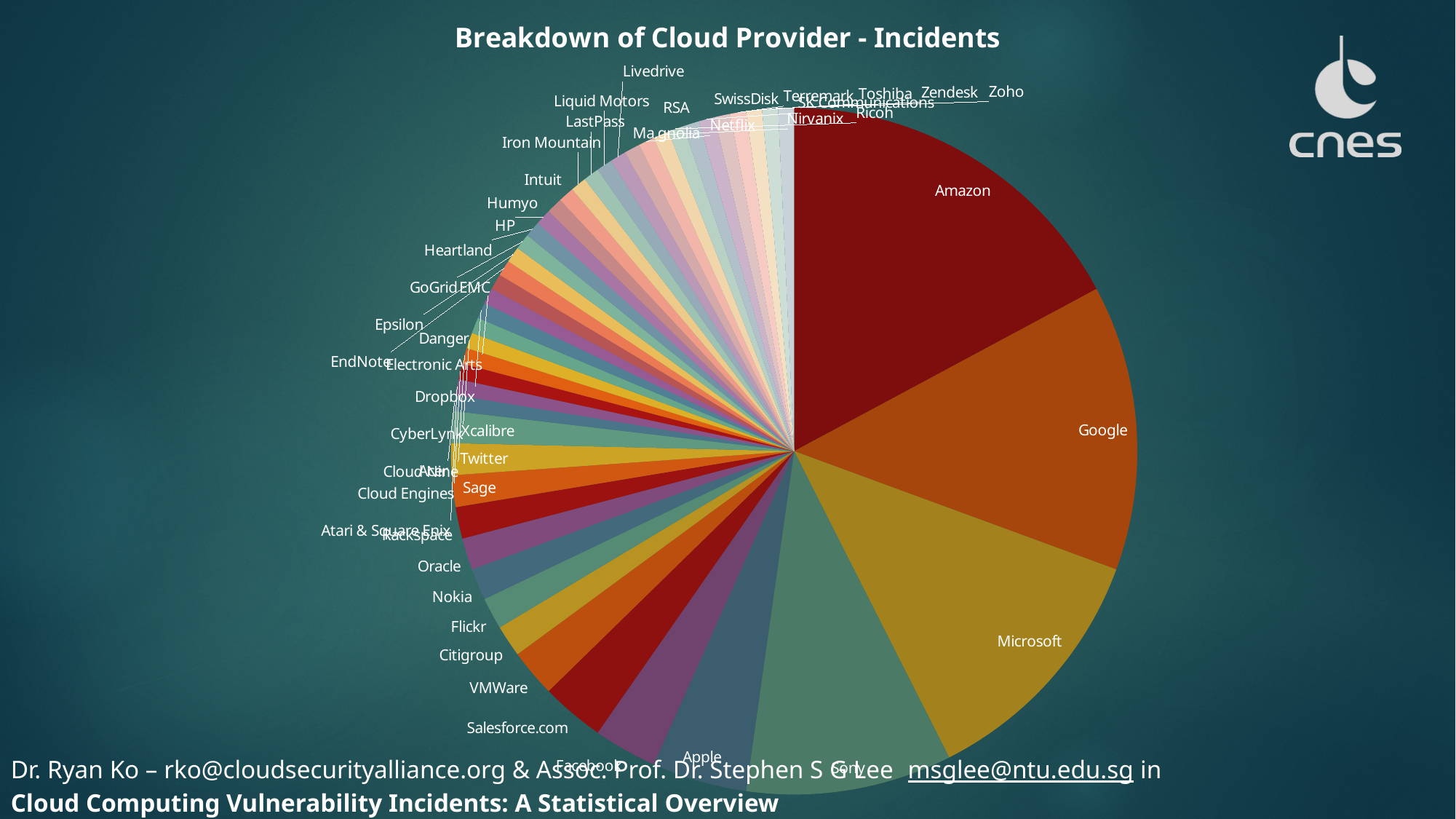
Which slice is larger, Sony or Facebook? Sony What kind of chart is shown on the slide? pie chart Which cloud provider has the largest slice of the pie? Amazon Which slice is larger, Amazon or Microsoft? Amazon Which slice is larger, Microsoft or Salesforce.com? Microsoft What is the title of the chart? Breakdown of Cloud Provider - Incidents What colour is the Amazon slice of the pie? dark red